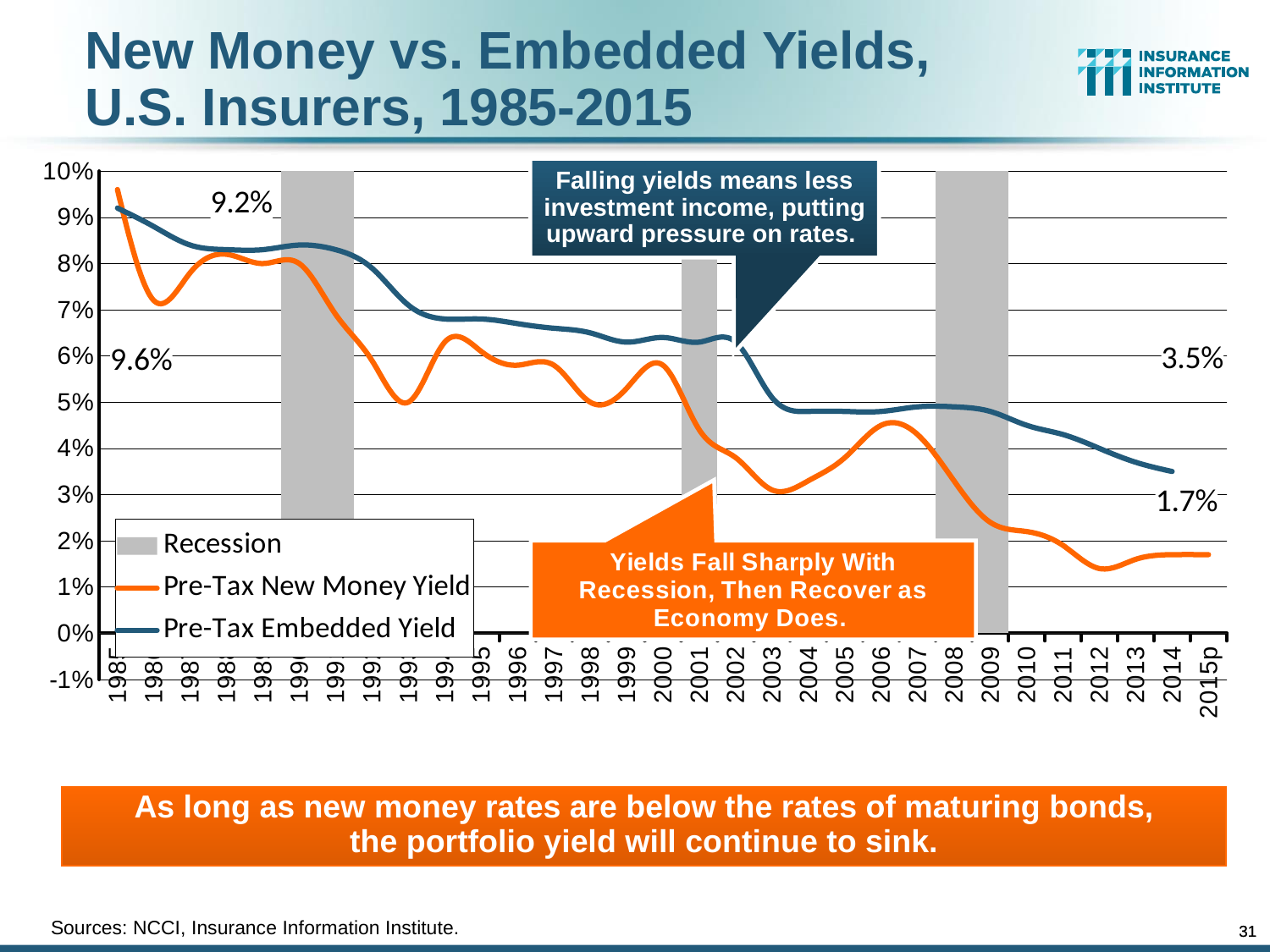
What is the Pre-Tax Embedded Yield at the start of the series in 1985? 9.2% Does the Pre-Tax Embedded Yield generally rise or fall from 1985 to 2015p? fall Is the Pre-Tax Embedded Yield in 2009 greater or less than 4%? greater What is the Pre-Tax New Money Yield at the start of the series in 1985? 9.6% How many entries does the chart legend list? 3 Is the Pre-Tax New Money Yield in 2003 greater or less than 4%? less What kind of chart is shown on the slide? combination bar and line chart What is the Pre-Tax New Money Yield for 2015p? 1.7% What colour is the Pre-Tax New Money Yield line? orange